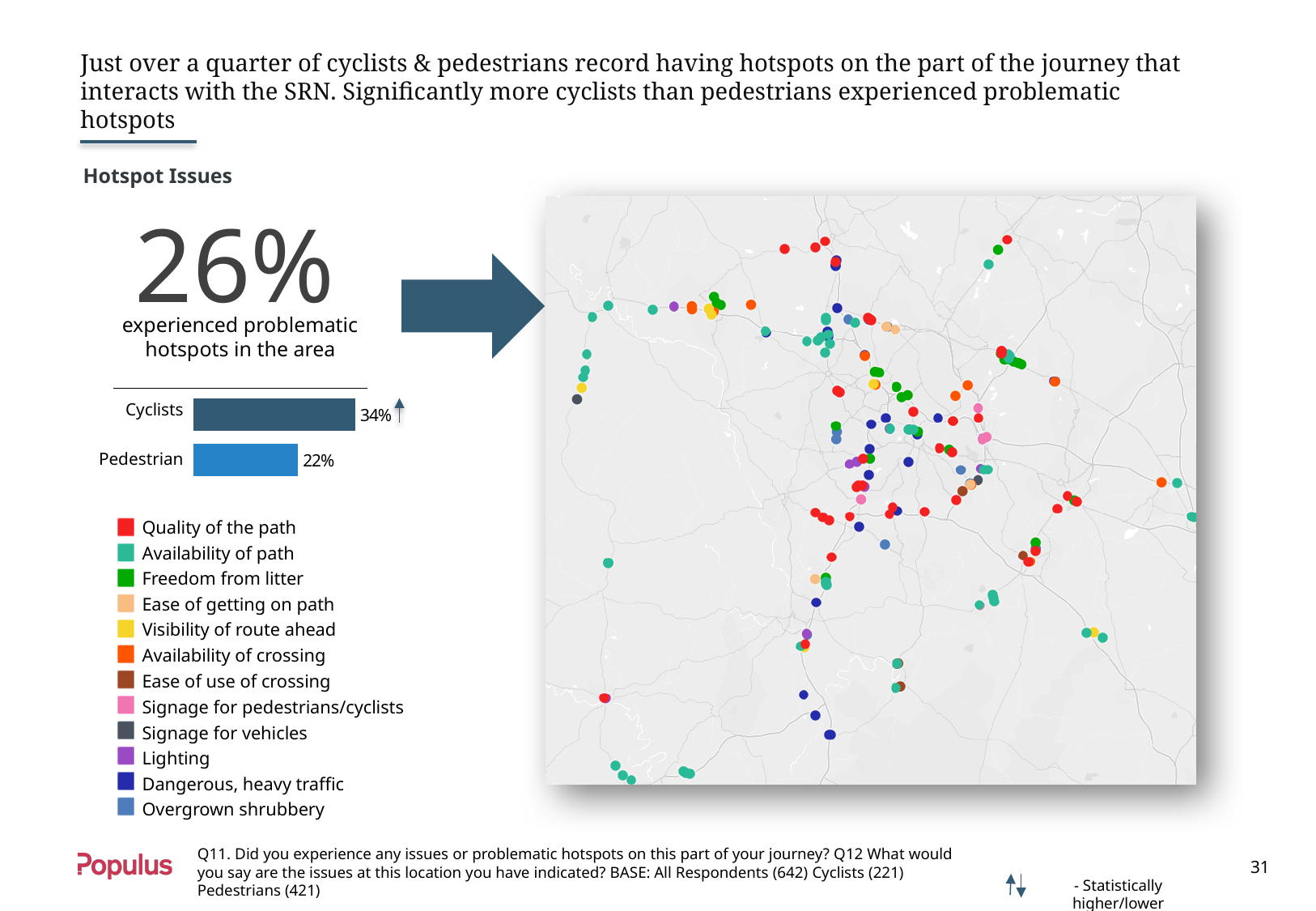
Which group has the higher share experiencing problematic hotspots, cyclists or pedestrians? Cyclists Which bar in the chart is marked with an arrow indicating it is statistically higher? Cyclists What type of chart is used to compare cyclists and pedestrians? Bar chart What is the difference in percentage points between cyclists and pedestrians experiencing problematic hotspots? 12 Which issue category in the map legend is shown in red? Quality of the path What percentage of pedestrians experienced problematic hotspots in the area? 22% Which group has the lowest share experiencing problematic hotspots? Pedestrian How many groups are shown in the bar chart under 'Hotspot Issues'? 2 What percentage of cyclists experienced problematic hotspots in the area? 34% What overall percentage of respondents experienced problematic hotspots in the area? 26% How many issue categories are listed in the legend for the hotspot map? 12